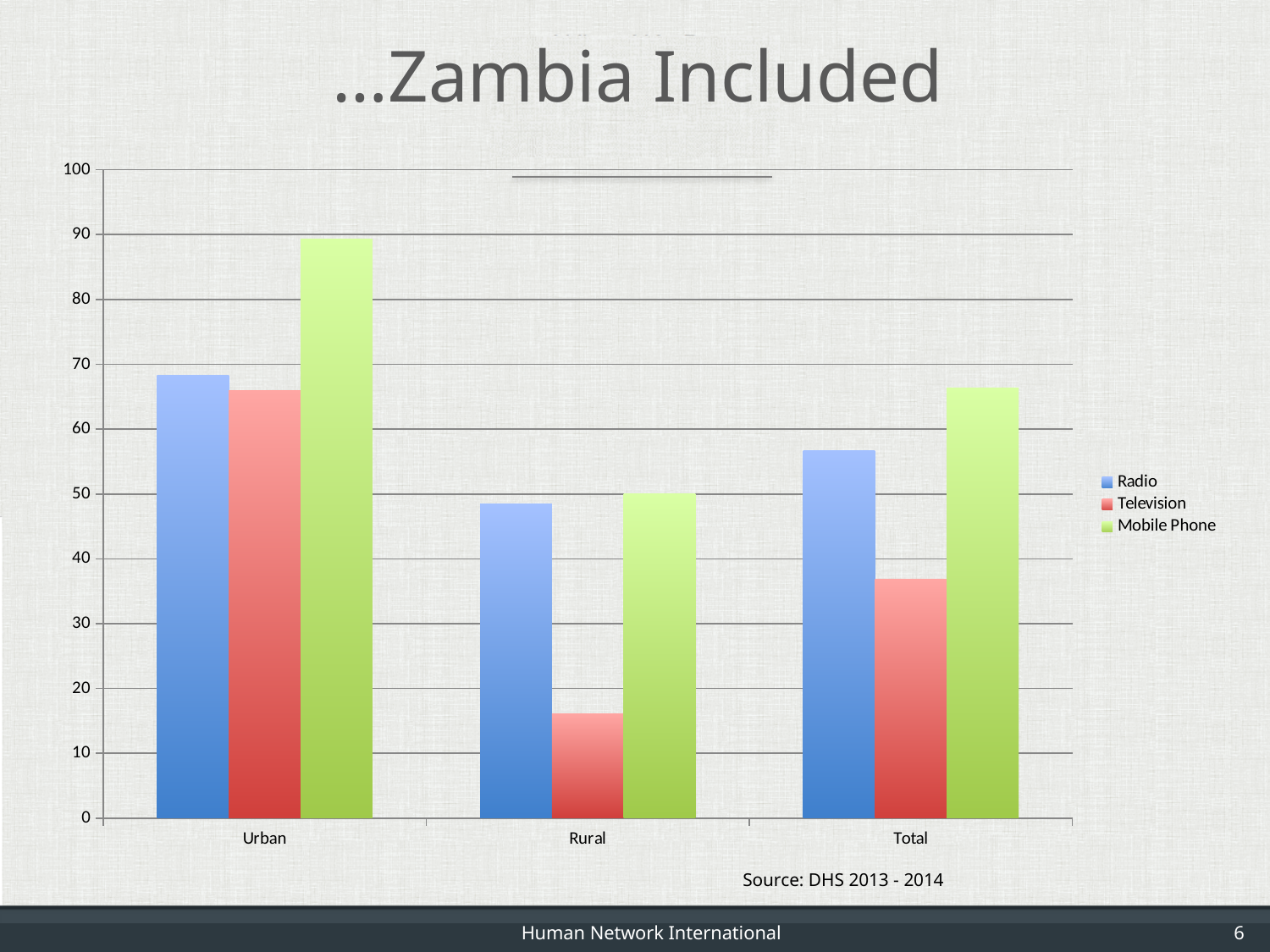
How many categories are shown on the x axis? 3 Which series has the highest value in the Urban category? Mobile Phone Which category has the highest Television value? Urban Is the Mobile Phone value for Urban greater or less than 80? greater Which category has the lowest Mobile Phone value? Rural Is the Radio value for Total greater or less than 50? greater Is the Television value for Rural greater or less than 20? less Which is larger in the Total category, Radio or Television? Radio What source is cited below the chart? DHS 2013 - 2014 How many series does the legend list? 3 Which series has the lowest value in the Rural category? Television What kind of chart is shown on the slide? bar chart